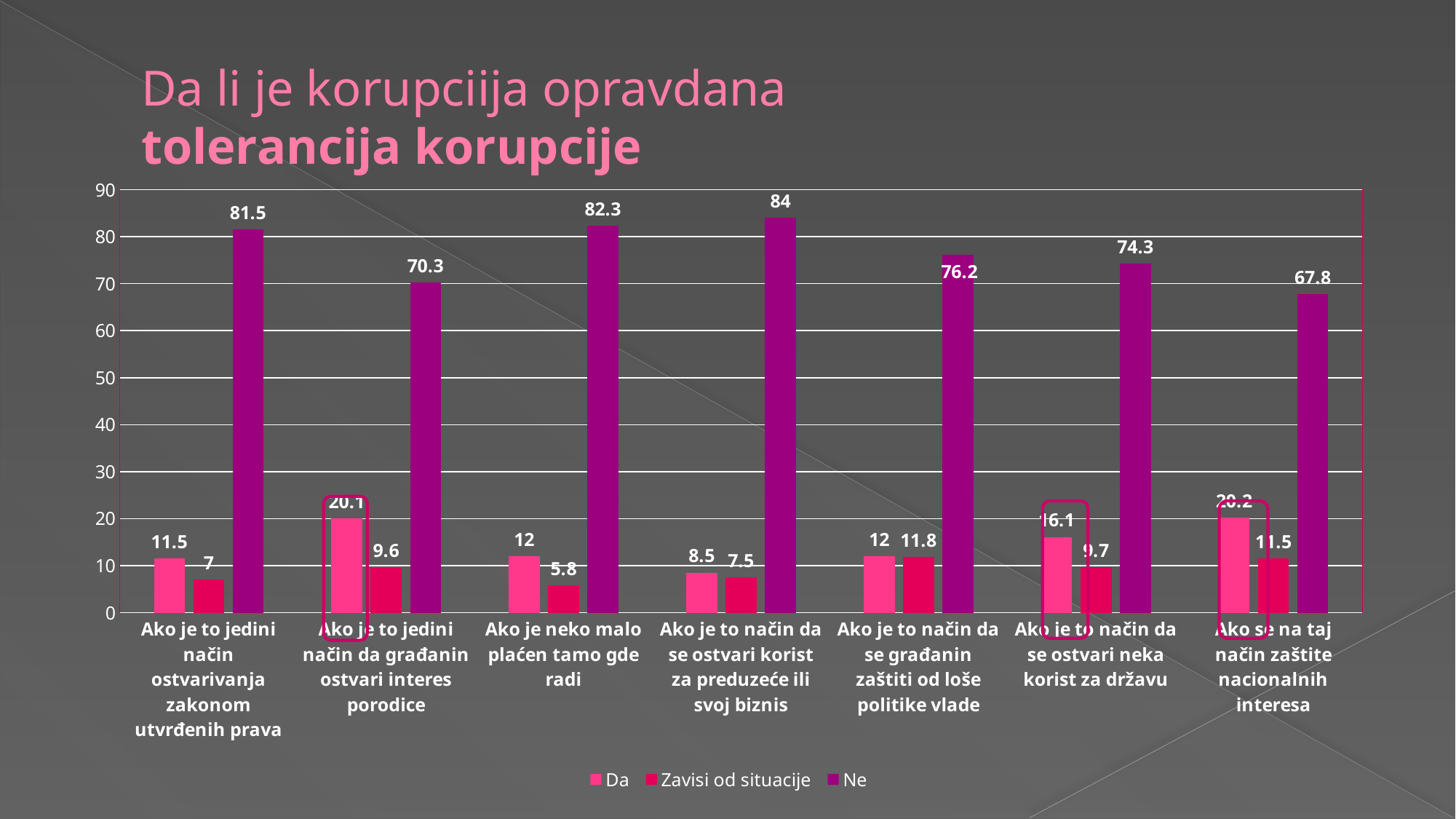
What is the value of the "Da" series for "Ako je neko malo plaćen tamo gde radi"? 12 Which category has the highest "Ne" value? Ako je to način da se ostvari korist za preduzeće ili svoj biznis What kind of chart is shown on the slide? bar chart What is the value of the "Ne" series for "Ako je to jedini način ostvarivanja zakonom utvrđenih prava"? 81.5 What is the difference between the "Ne" values for "Ako je to jedini način ostvarivanja zakonom utvrđenih prava" and "Ako je to jedini način da građanin ostvari interes porodice"? 11.2 Which category has the lowest "Ne" value? Ako se na taj način zaštite nacionalnih interesa Which is larger: the "Da" value for "Ako je to način da se ostvari neka korist za državu" or the "Da" value for "Ako je to način da se građanin zaštiti od loše politike vlade"? Ako je to način da se ostvari neka korist za državu What are the three series listed in the legend? Da, Zavisi od situacije, Ne How many series does the legend list? 3 What is the value of the "Zavisi od situacije" series for "Ako je to način da se ostvari korist za preduzeće ili svoj biznis"? 7.5 How many categories are shown on the x axis? 7 Which category has the lowest "Zavisi od situacije" value? Ako je neko malo plaćen tamo gde radi